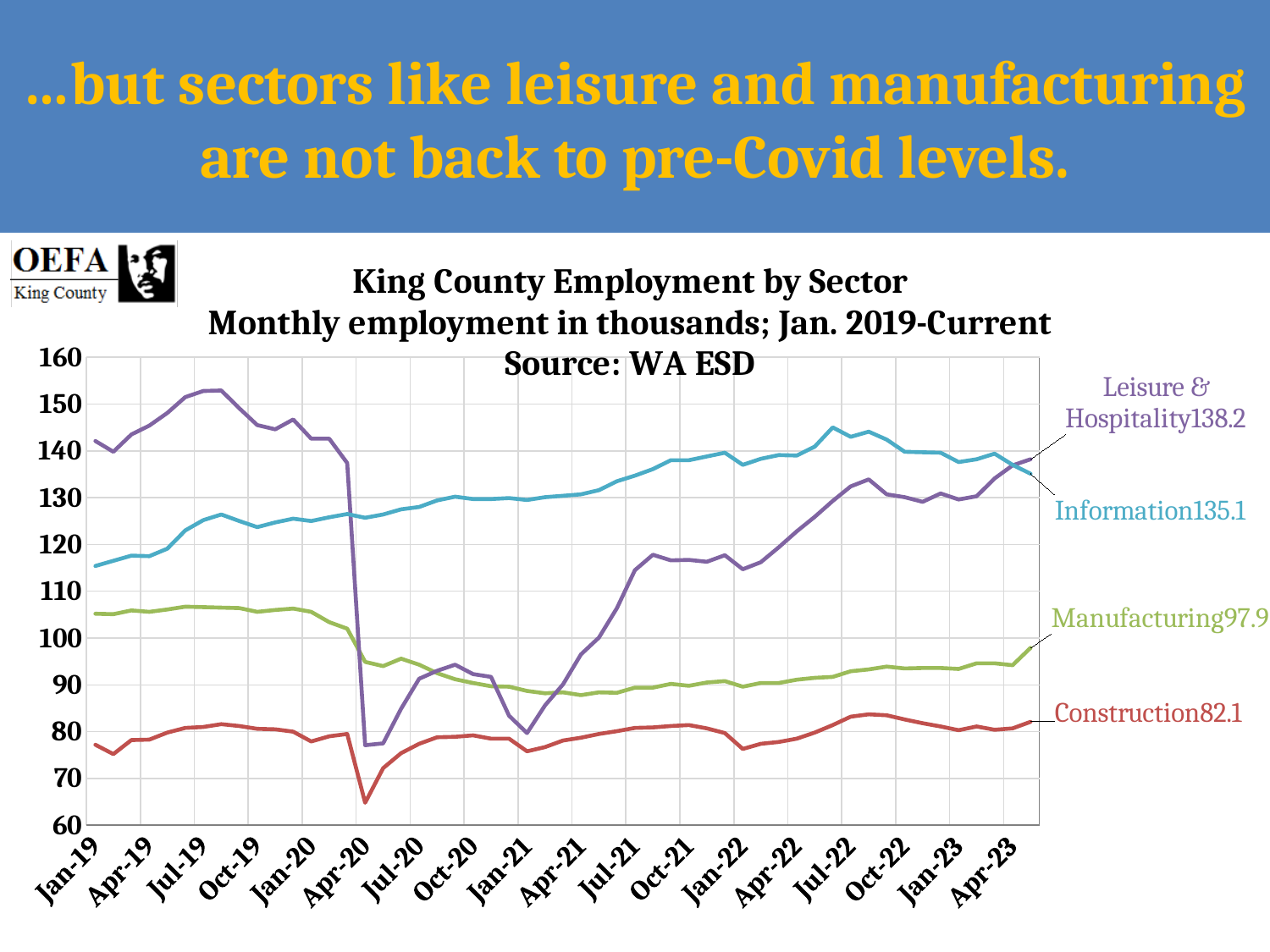
What is the latest value shown for Construction? 82.1 Does the Information line generally rise or fall from Jan-19 to Jul-22? rise Which sector has the highest latest value on the chart? Leisure & Hospitality What source is cited in the chart title? WA ESD What is the difference between the latest values for Manufacturing and Construction? 15.8 What is the latest value shown for Information? 135.1 Which sector has the lowest latest value on the chart? Construction What kind of chart is shown on the slide? line chart What is the latest value shown for Leisure & Hospitality? 138.2 What is the latest value shown for Manufacturing? 97.9 Is the value for Construction in Apr-20 greater or less than 70? less How many sectors (series) are plotted on the chart? 4